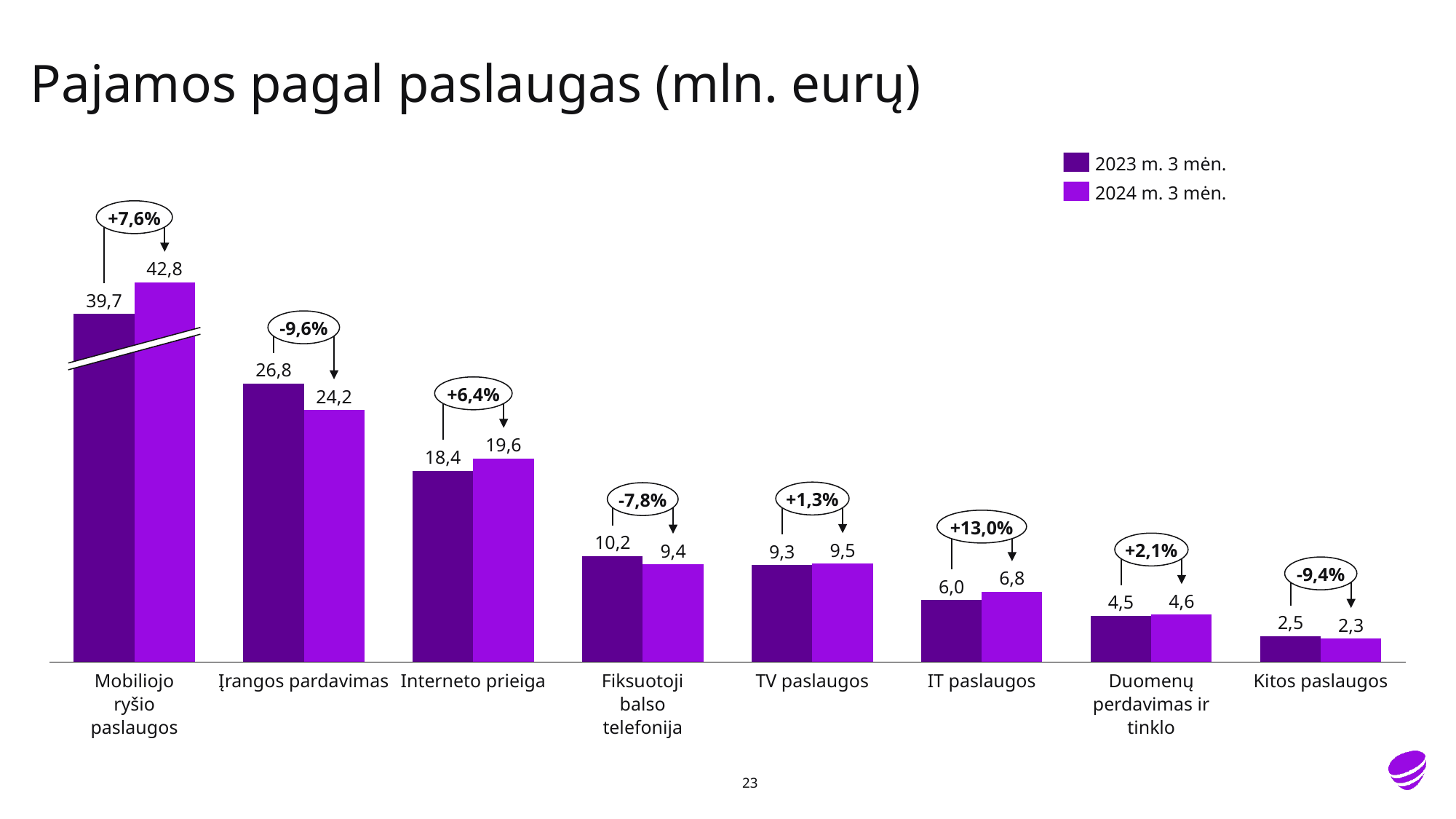
For Fiksuotoji balso telefonija, which series has the larger value, 2023 m. 3 mėn. or 2024 m. 3 mėn.? 2023 m. 3 mėn. What percentage change is shown above the bars for IT paslaugos? +13,0% What is the difference between the 2024 m. 3 mėn. and 2023 m. 3 mėn. values for Mobiliojo ryšio paslaugos? 3,1 What is the value for IT paslaugos in the 2024 m. 3 mėn. series? 6,8 Which category has the highest value in the 2024 m. 3 mėn. series? Mobiliojo ryšio paslaugos How many categories are shown on the x axis? 8 What is the value for Įrangos pardavimas in the 2023 m. 3 mėn. series? 26,8 What kind of chart is shown on the slide? Bar chart Which category has the lowest value in the 2023 m. 3 mėn. series? Kitos paslaugos What is the difference between the 2023 m. 3 mėn. and 2024 m. 3 mėn. values for Įrangos pardavimas? 2,6 How many series does the legend list? 2 What is the value for Mobiliojo ryšio paslaugos in the 2024 m. 3 mėn. series? 42,8